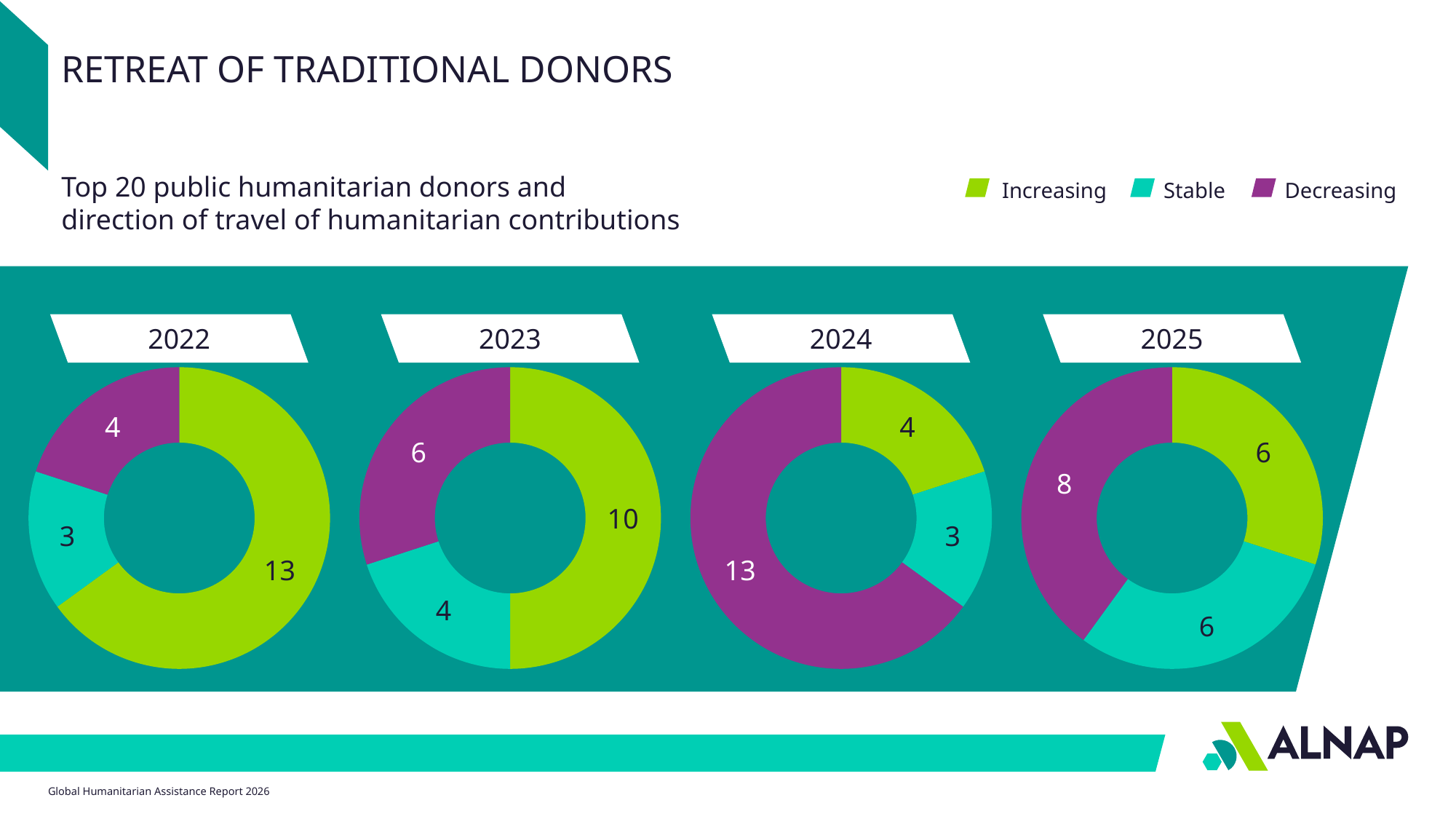
In the 2022 chart, how many donors are in the Increasing category? 13 In the 2024 chart, how many donors are in the Decreasing category? 13 In the 2023 chart, what share of the donors are in the Decreasing category? 30% In the 2022 chart, which category has the smallest number of donors? Stable In the 2024 chart, which is larger, the Increasing value or the Stable value? Increasing How does the Decreasing value change from the 2022 chart to the 2024 chart? It rises Which colour represents the Stable category in the legend? Teal How many series does the legend list? 3 In the 2025 chart, what is the difference between the Decreasing and Increasing values? 2 What kind of chart is used for each year on the slide? Donut chart In the 2023 chart, which category has the largest number of donors? Increasing In the 2025 chart, how many donors are in the Stable category? 6